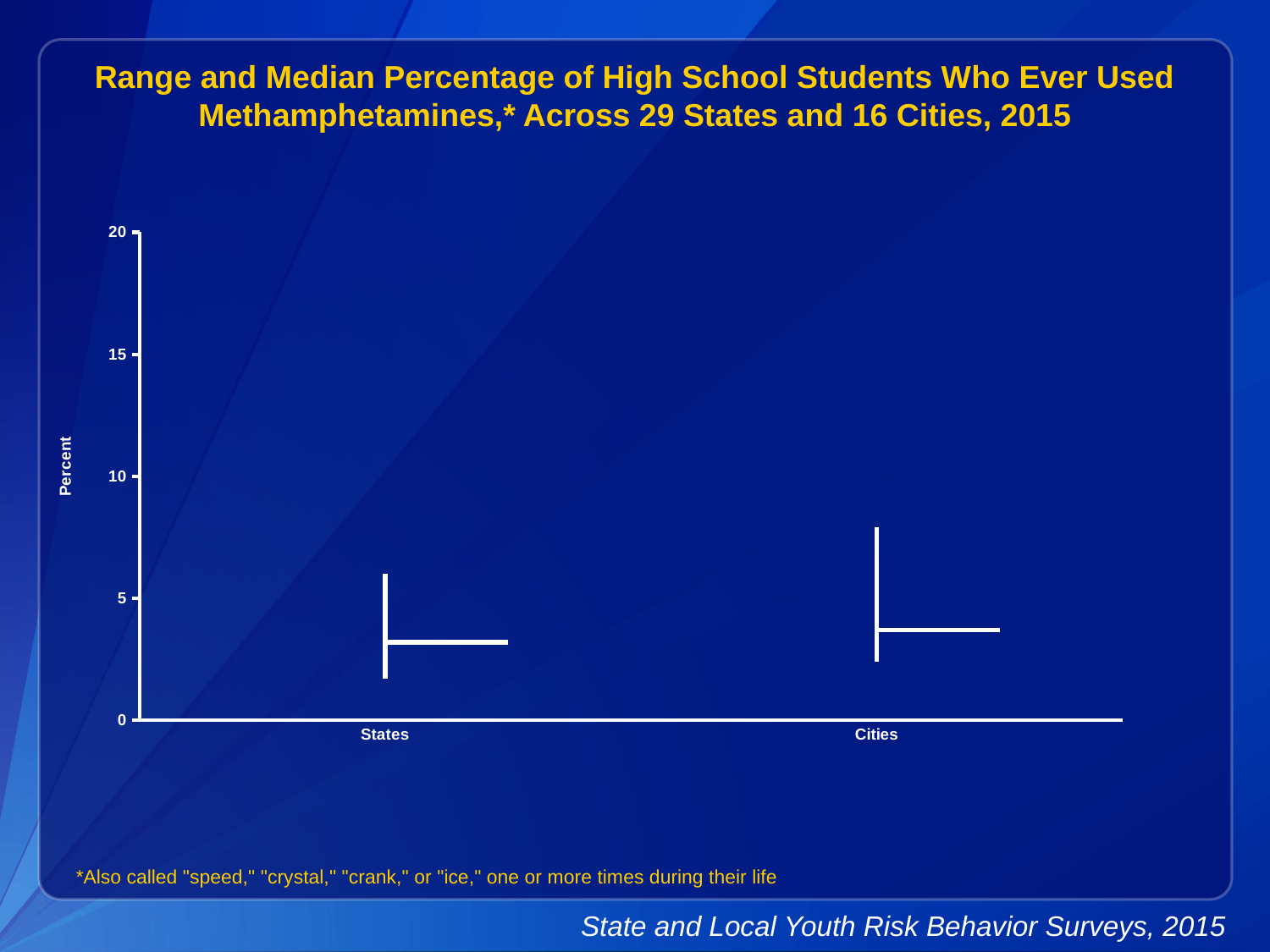
Which category has the higher top of its range, States or Cities? Cities What is the highest value shown on the y axis? 20 Is the bottom of the range for States greater or less than 5? less Which category has the lower bottom of its range, States or Cities? States What is the label on the y axis of the chart? Percent Is the top of the range for States greater or less than 5? greater How many categories are shown on the x axis of the chart? 2 What are the two categories shown on the x axis? States and Cities Is the median value for Cities greater or less than 5? less